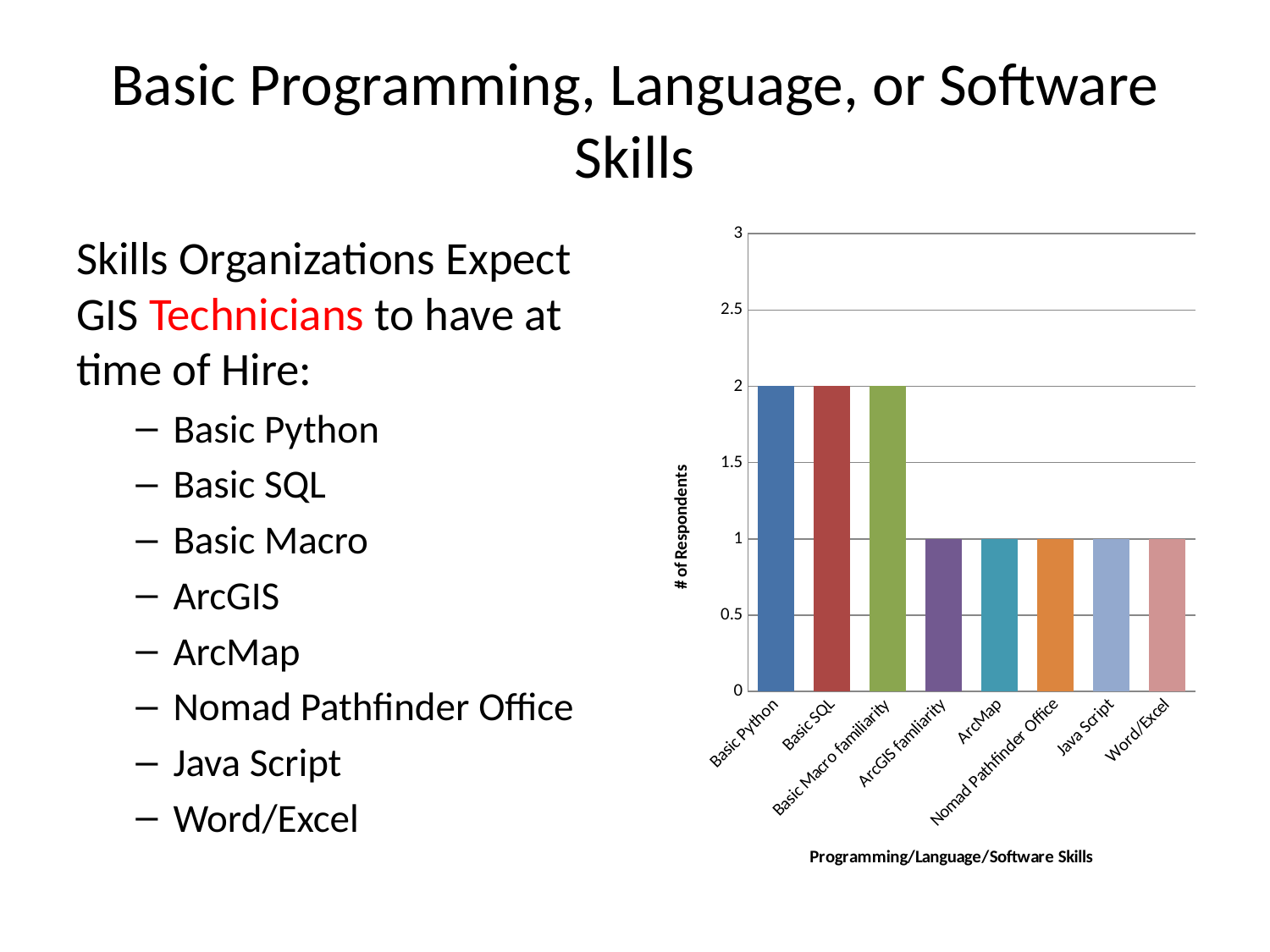
Do the values rise or fall moving from left to right along the x axis? fall What kind of chart is shown on the slide? bar chart How many categories are shown on the x axis of the chart? 8 What is the value for ArcMap in the chart? 1 Which is larger, the value for Basic SQL or the value for Java Script? Basic SQL What is the difference between the value for Basic SQL and the value for Nomad Pathfinder Office? 1 What is the title of the vertical axis of the chart? # of Respondents What is the value for Basic Python in the chart? 2 What is the value for Basic Macro familiarity in the chart? 2 Is the value for ArcGIS familiarity greater or less than 1.5? less Is the value for Basic Python greater or less than 1.5? greater What is the value for Word/Excel in the chart? 1